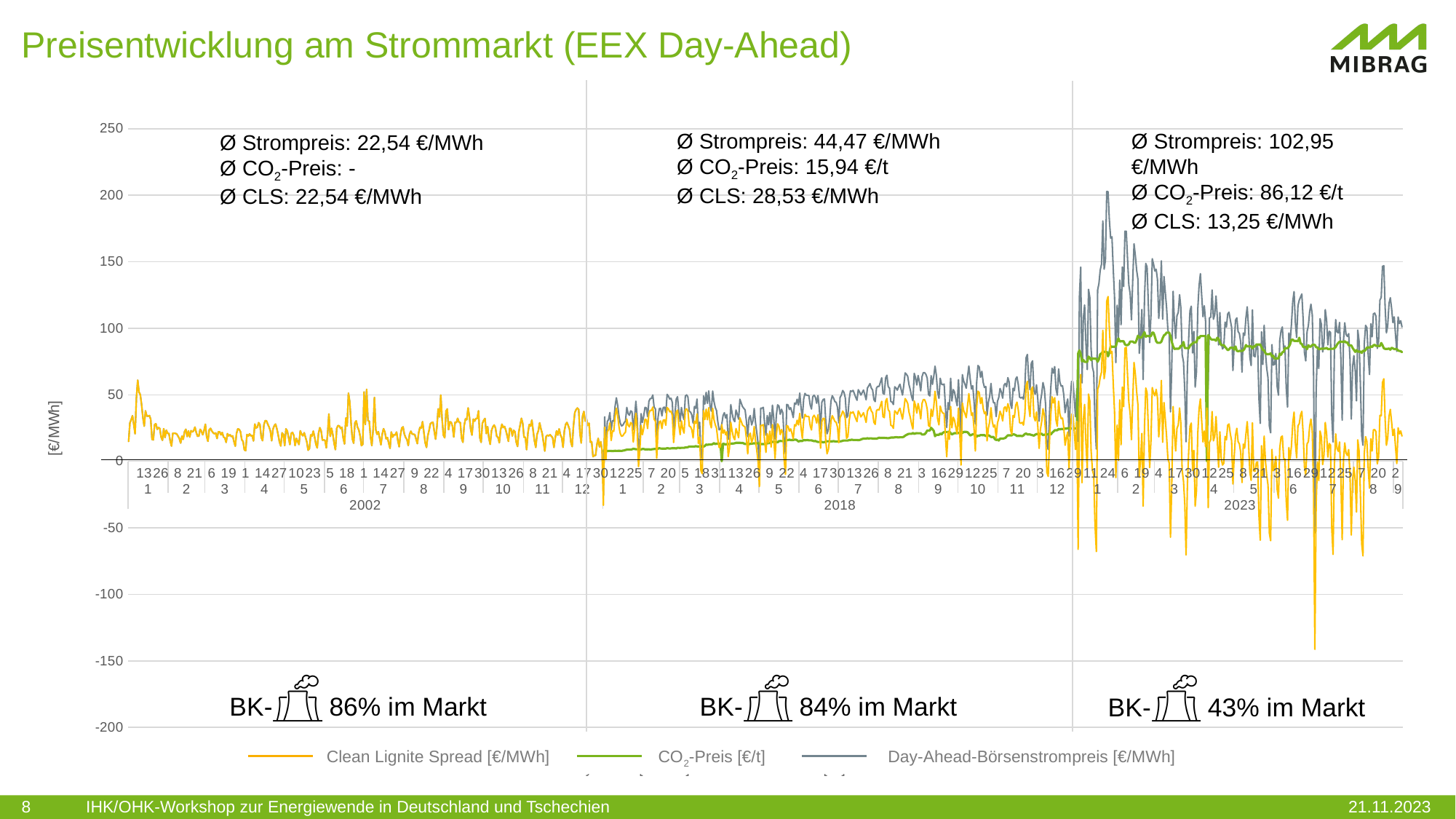
What is the average Strompreis given for the 2023 period? 102,95 €/MWh What is the average CLS given for the 2023 period? 13,25 €/MWh What is the average Strompreis (Ø Strompreis) given for the 2002 period? 22,54 €/MWh How many series does the legend list? 3 What is the average CO2-Preis given for the 2018 period? 15,94 €/t Which three years are shown on the x axis of the chart? 2002, 2018, 2023 Does the Day-Ahead-Börsenstrompreis line rise or fall over the course of the 2018 period? rise What share of BK (lignite) is stated to be in the market in the 2023 period? 43% im Markt What kind of chart is shown on the slide? Line chart Which period has the highest average Strompreis: 2002, 2018 or 2023? 2023 Is the CO2-Preis line in the 2023 period mostly greater or less than 50? greater What is the difference between the average Strompreis in 2023 and in 2018? 58,48 €/MWh